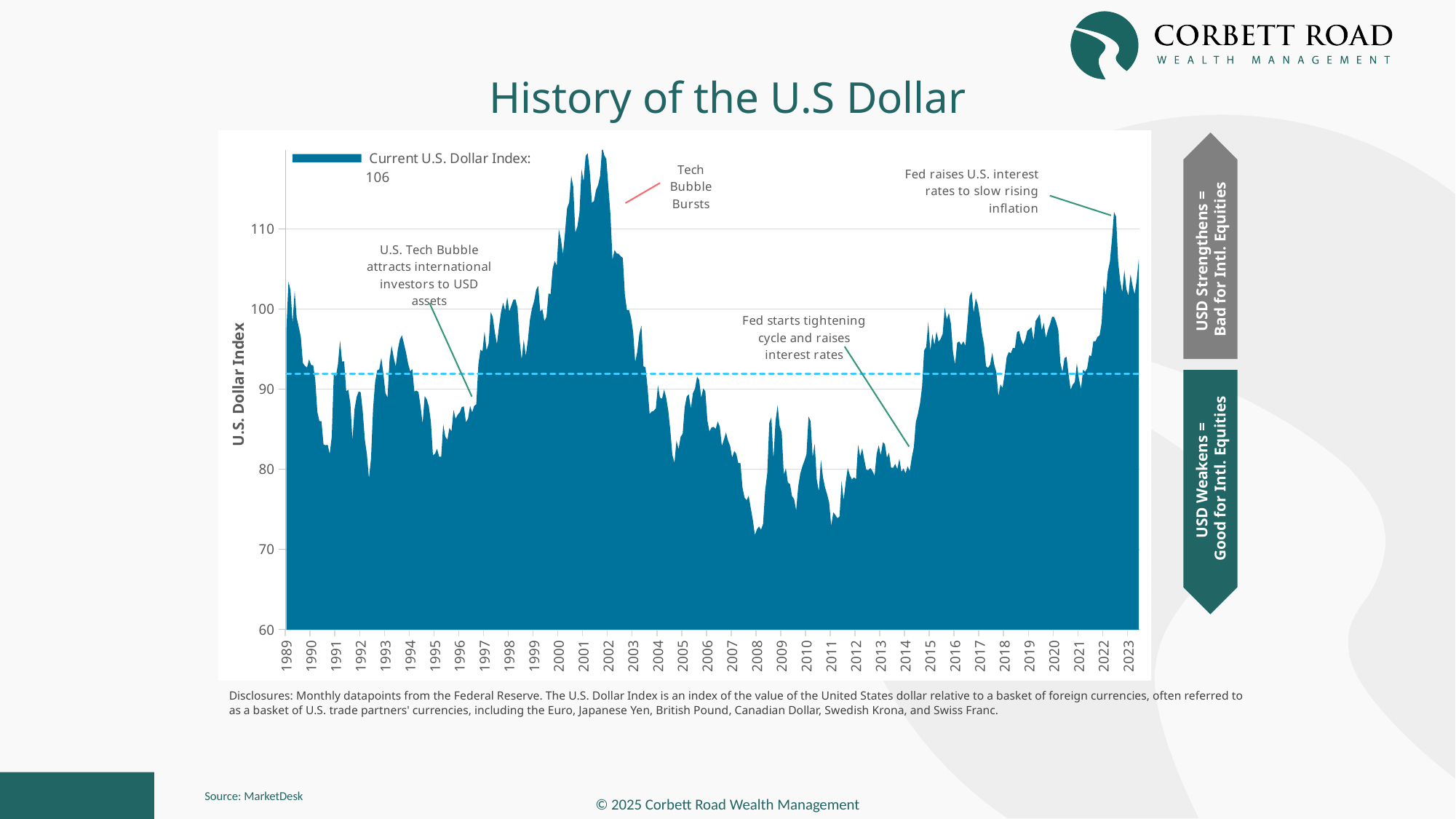
Around which year does the U.S. Dollar Index reach its highest point on the chart? 2002 Is the value of the U.S. Dollar Index at its 2008 low greater or less than 80? less What is the title of the slide's chart? History of the U.S Dollar What kind of chart is used to show the U.S. Dollar Index over time? Area chart What is the label on the vertical axis of the chart? U.S. Dollar Index How many series does the chart legend list? 1 What is the current U.S. Dollar Index value shown in the chart legend? 106 Which is higher on the chart: the U.S. Dollar Index peak around 2001 or the peak around 2022? The peak around 2001 Is the value of the U.S. Dollar Index in early 2014 greater or less than 90? less Is the value of the U.S. Dollar Index at its peak around 2001 greater or less than 110? greater Around which year does the U.S. Dollar Index reach its lowest point on the chart? 2008 Does the U.S. Dollar Index rise or fall between 2002 and 2008? Fall